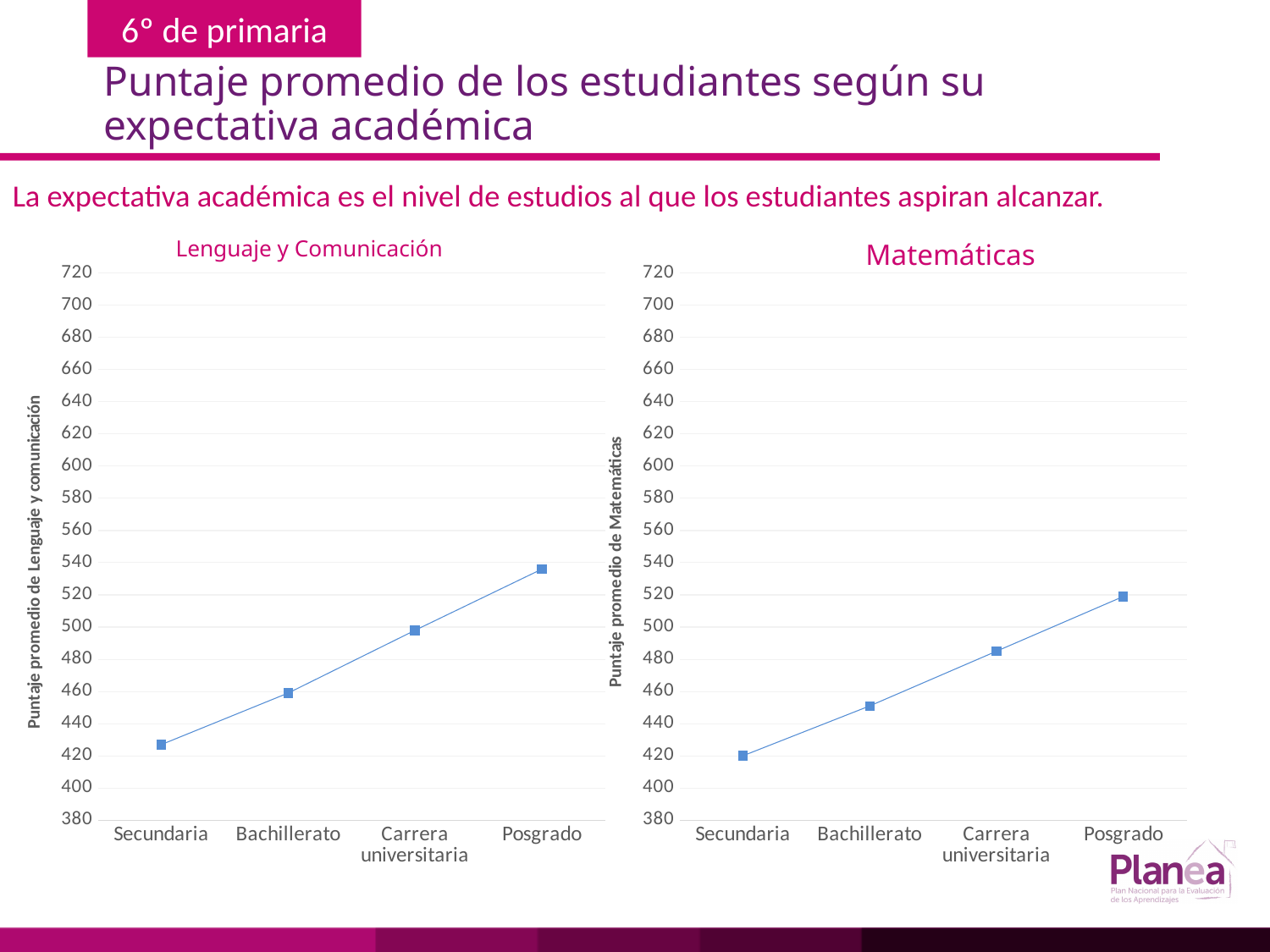
In the Matemáticas chart, is the value for Posgrado greater or less than 500? greater In the Lenguaje y Comunicación chart, which is larger, the value for Bachillerato or the value for Carrera universitaria? Carrera universitaria What is the y-axis label of the Matemáticas chart? Puntaje promedio de Matemáticas In the Lenguaje y Comunicación chart, which category has the highest score? Posgrado In the Matemáticas chart, is the value for Secundaria greater or less than 440? less In the Lenguaje y Comunicación chart, is the value for Secundaria greater or less than 440? less In the Matemáticas chart, do the values rise or fall from Secundaria to Posgrado? rise What kind of chart is the Lenguaje y Comunicación chart? line chart How many categories are shown on the x axis of the Matemáticas chart? 4 In the Matemáticas chart, which category has the lowest score? Secundaria